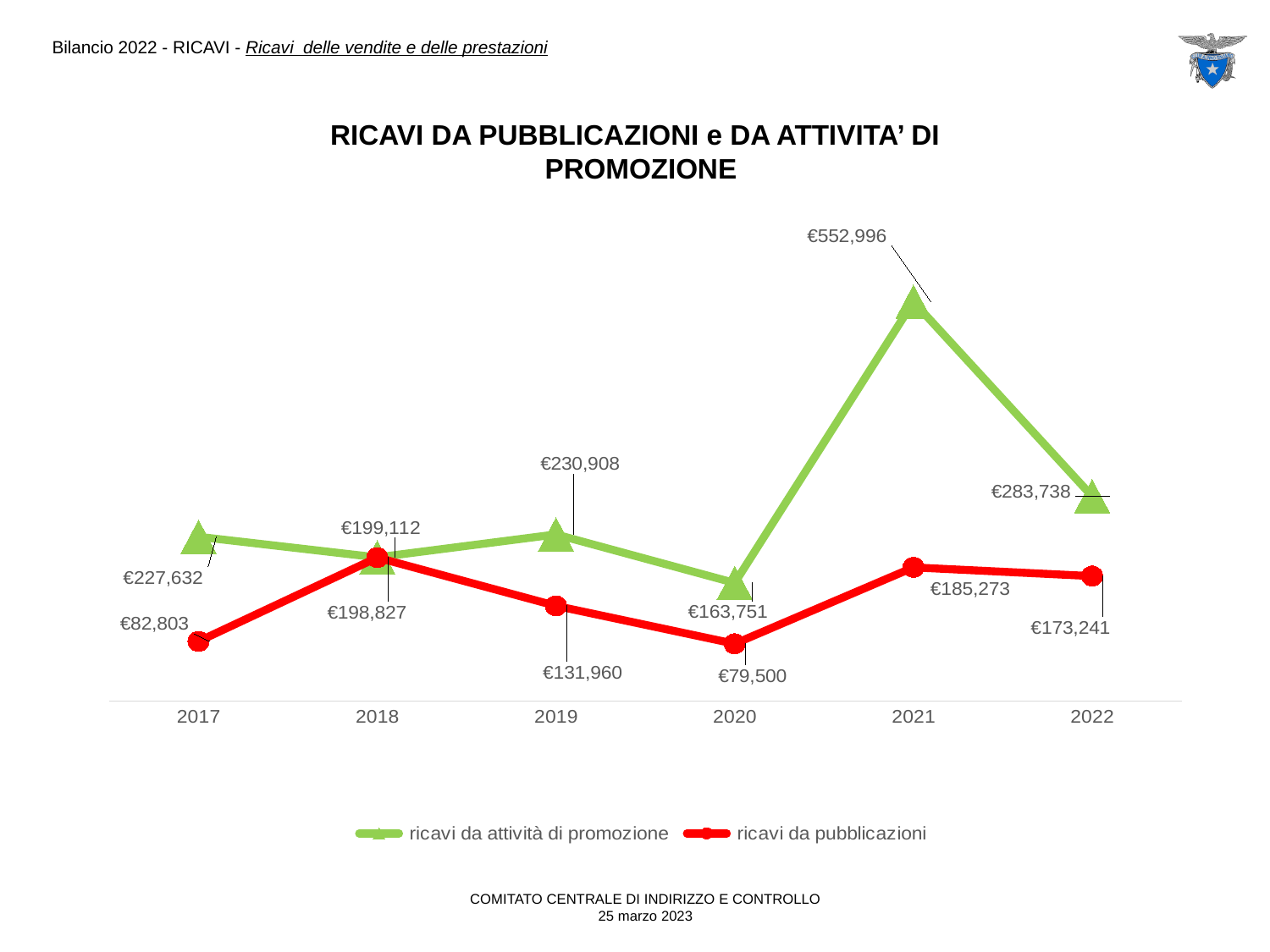
Does ricavi da pubblicazioni rise or fall from 2020 to 2021? rise What is the difference between ricavi da attività di promozione in 2021 and in 2022? €269,258 In which year is ricavi da attività di promozione lowest? 2020 In which year is ricavi da attività di promozione highest? 2021 What is the value of ricavi da pubblicazioni in 2022? €173,241 In which year is ricavi da pubblicazioni lowest? 2020 What kind of chart is shown on the slide? line chart How many series does the legend list? 2 What is the value of ricavi da attività di promozione in 2021? €552,996 What is the value of ricavi da pubblicazioni in 2017? €82,803 In 2019, which series has the larger value, ricavi da attività di promozione or ricavi da pubblicazioni? ricavi da attività di promozione How many years are shown on the x axis? 6